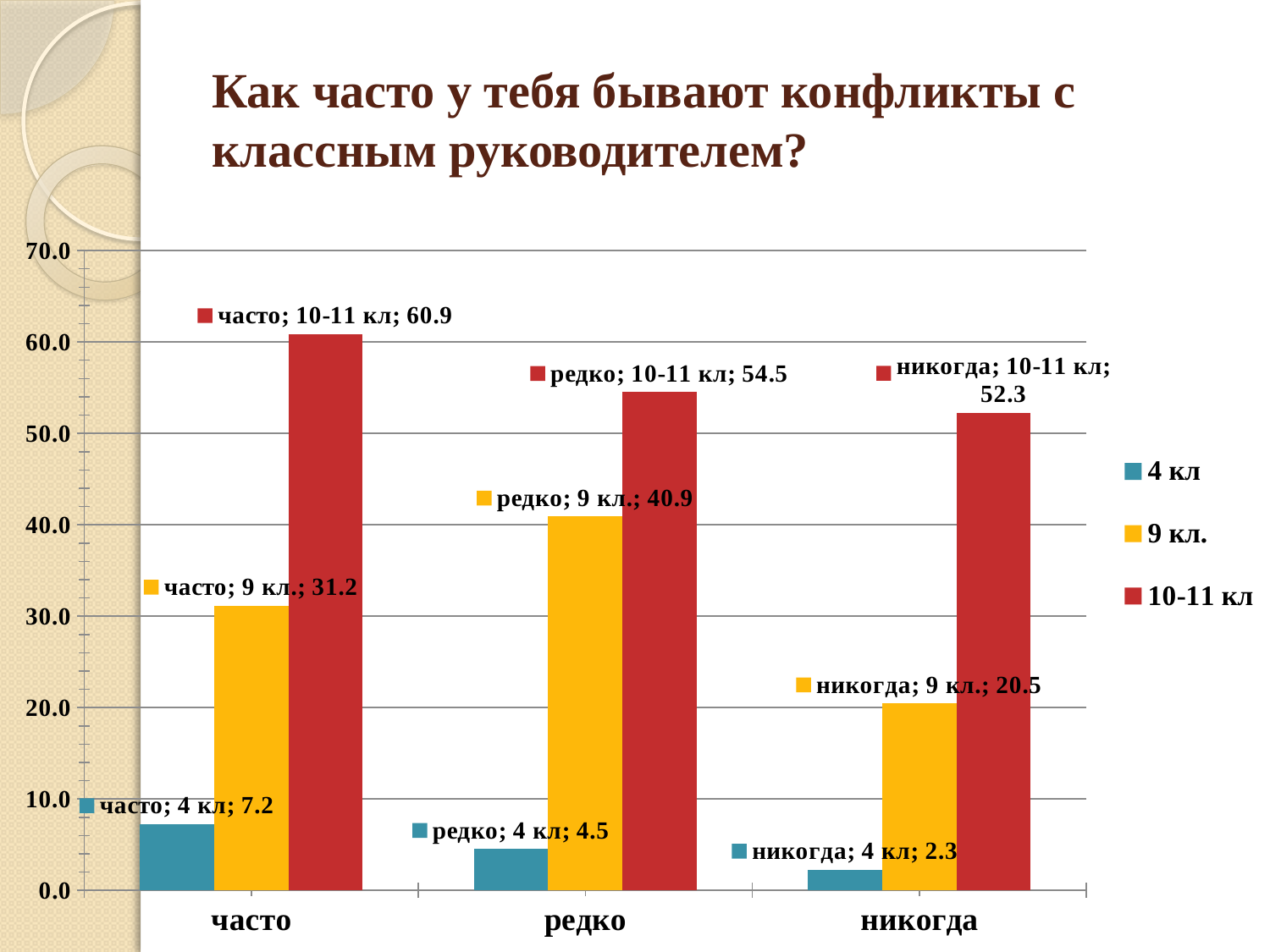
How many categories are shown on the x axis? 3 Which is larger: the 10-11 кл value for редко or the 10-11 кл value for никогда? редко What is the difference between the 10-11 кл value and the 9 кл. value in the часто category? 29.7 What is the value for 10-11 кл in the часто category? 60.9 What is the value for 9 кл. in the никогда category? 20.5 Is the value for 9 кл. in the часто category greater or less than 30.0? greater Which category has the lowest value for the 4 кл series? никогда How many series does the legend list? 3 Which category has the highest value for the 9 кл. series? редко What kind of chart is shown on the slide? bar chart Do the values for the 4 кл series rise or fall from часто to никогда? fall What is the value for 4 кл in the редко category? 4.5